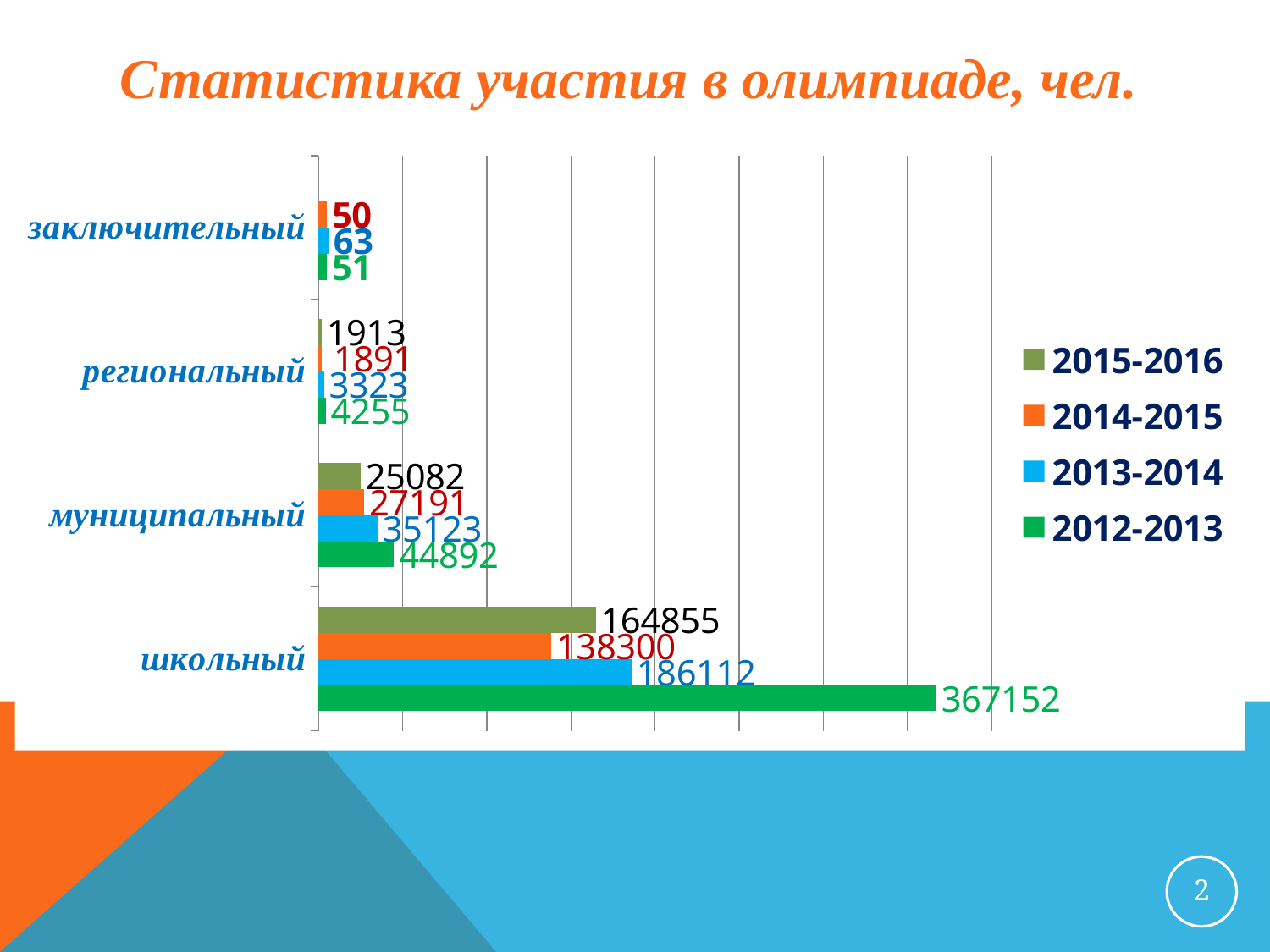
What is the value for заключительный in the 2014-2015 series? 50 What is the value for региональный in the 2013-2014 series? 3323 Which series has the lowest value for муниципальный? 2015-2016 What is the value for муниципальный in the 2015-2016 series? 25082 How many categories are shown on the vertical axis? 4 Which series has the highest value for школьный? 2012-2013 What type of chart is shown on the slide? bar chart How many series does the legend list? 4 Which is larger for региональный: the 2015-2016 value or the 2014-2015 value? 2015-2016 What is the difference between the 2013-2014 and 2014-2015 values for школьный? 47812 What is the title of the chart? Статистика участия в олимпиаде, чел. What is the value for школьный in the 2012-2013 series? 367152